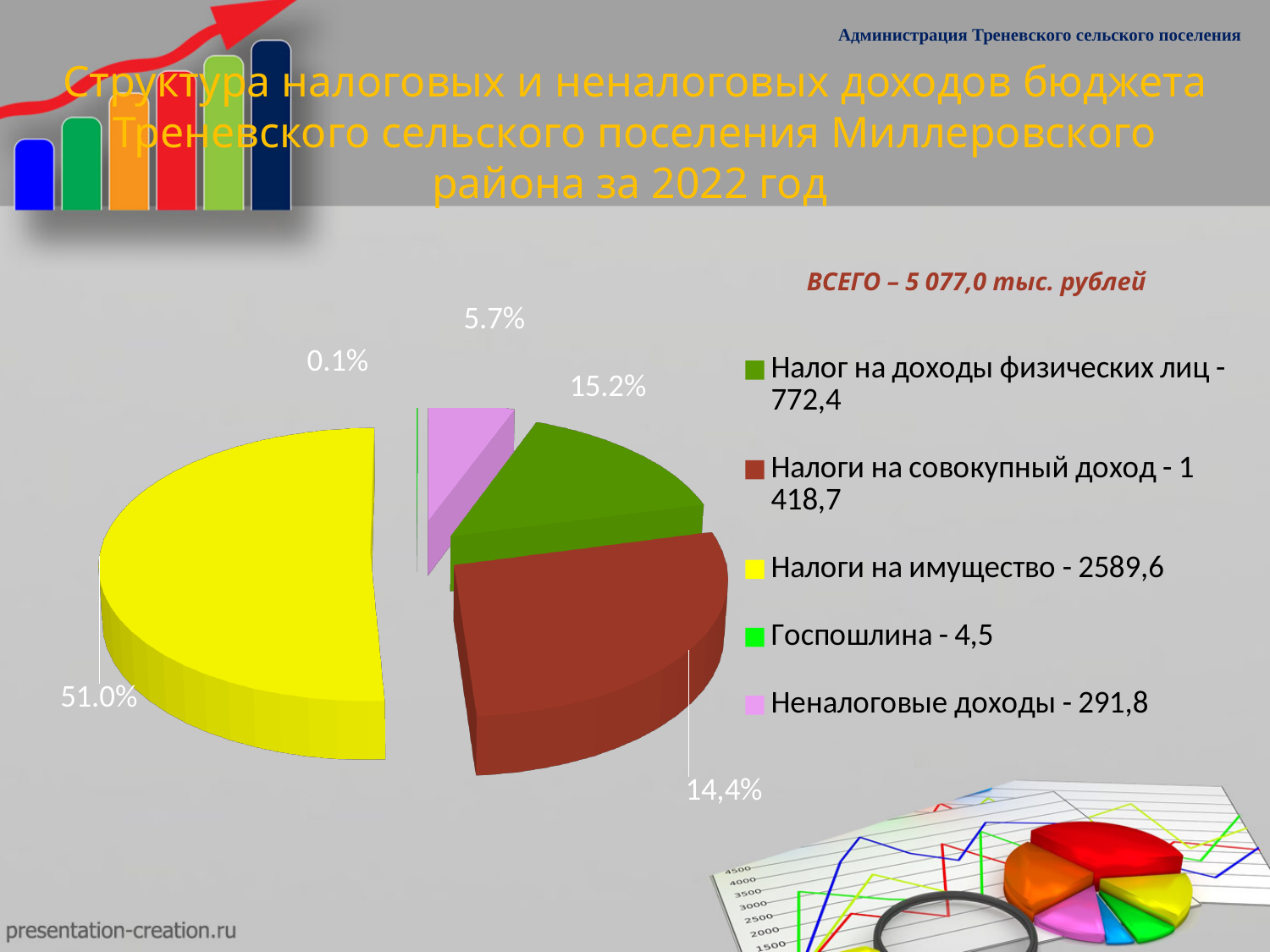
What kind of chart is shown on the slide? pie chart What share of the pie is labelled for Налоги на имущество? 51.0% What percentage is shown for Неналоговые доходы? 5.7% Which slice is larger: Налог на доходы физических лиц or Неналоговые доходы? Налог на доходы физических лиц What percentage is shown for Налог на доходы физических лиц? 15.2% How many categories does the pie chart's legend list? 5 What is the difference in percentage points between the Налоги на имущество slice (51.0%) and the Налог на доходы физических лиц slice (15.2%)? 35.8% What total amount (ВСЕГО) is stated above the legend? 5 077,0 тыс. рублей Which category has the largest slice of the pie? Налоги на имущество What value does the legend give for Налоги на совокупный доход? 1 418,7 What percentage is shown for Госпошлина? 0.1% Which category has the smallest slice of the pie? Госпошлина